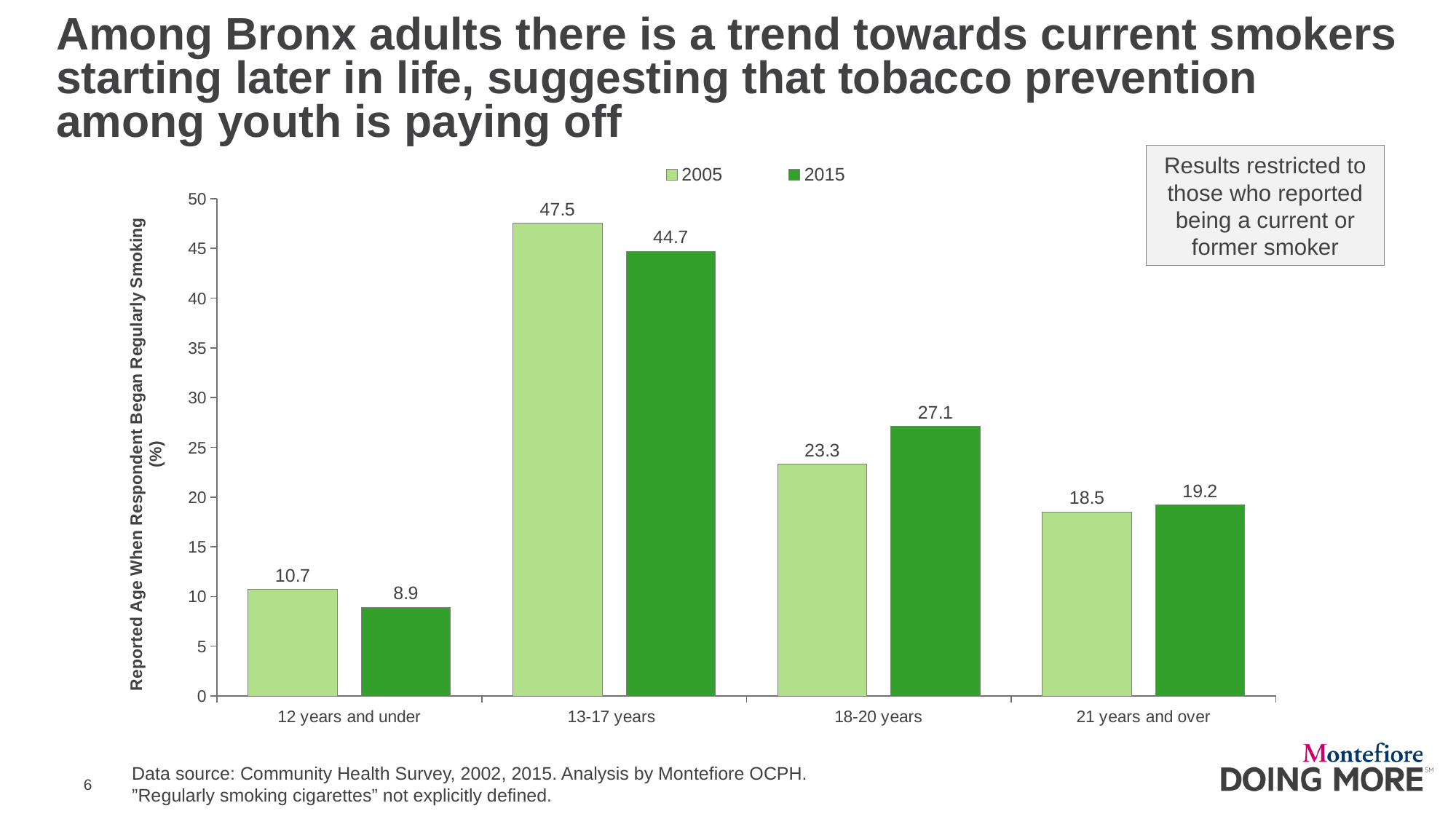
How many age categories are shown on the x axis? 4 For the 12 years and under category, which year has the larger value, 2005 or 2015? 2005 What is the 2015 value for the 12 years and under category? 8.9 What is the 2015 value for the 18-20 years category? 27.1 What is the 2005 value for the 13-17 years category? 47.5 What kind of chart is shown on the slide? bar chart What is the difference between the 2005 and 2015 values for the 13-17 years category? 2.8 Is the 2005 value for the 21 years and over category greater or less than 20? less What is the difference between the 2005 and 2015 values for the 18-20 years category? 3.8 How many series does the legend list? 2 Which age category has the highest 2015 value? 13-17 years Which age category has the lowest 2005 value? 12 years and under